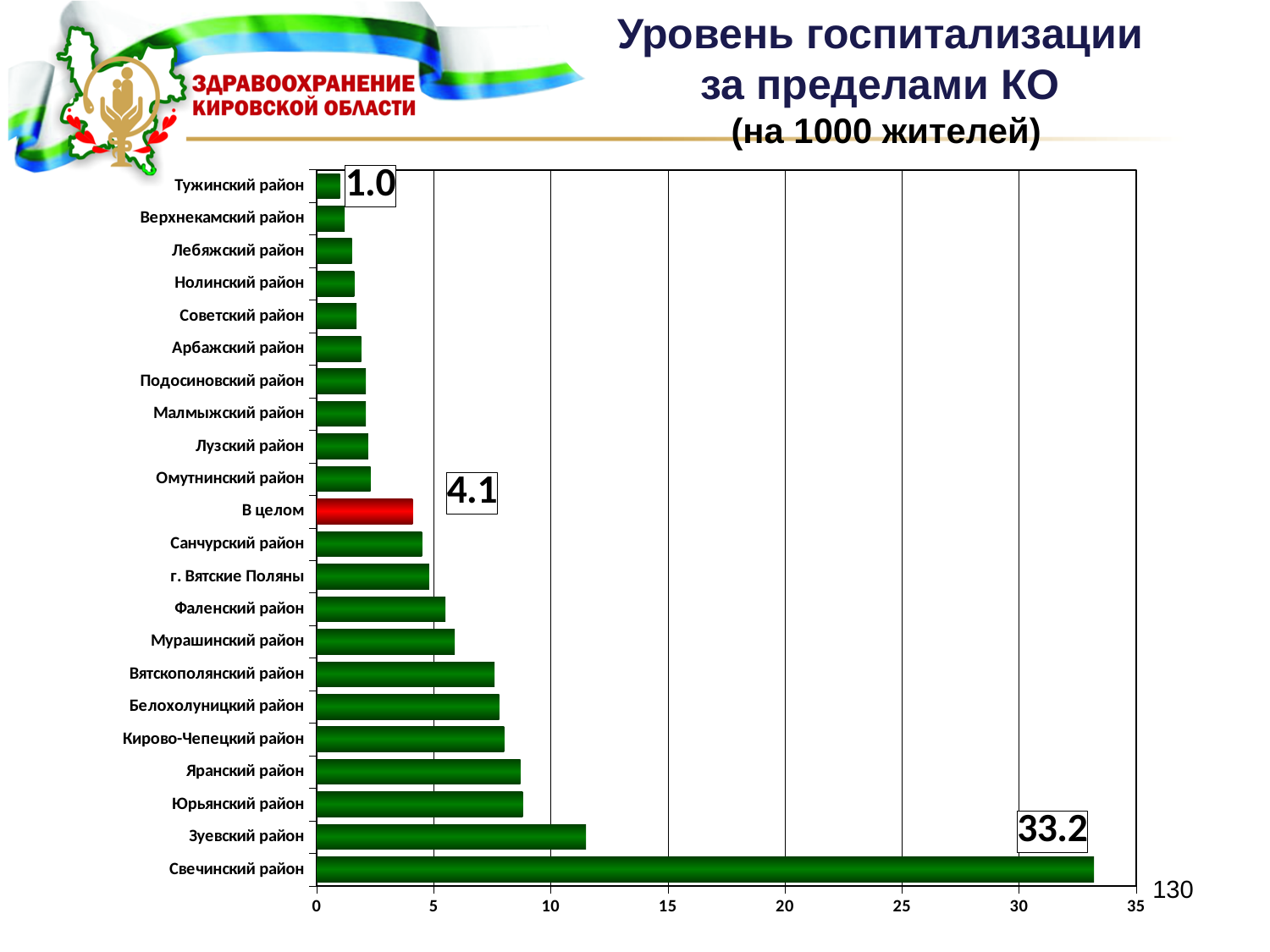
What is the difference between the values for Свечинский район and Тужинский район? 32.2 Is the value for Кирово-Чепецкий район greater or less than 10? less What is the value for В целом? 4.1 Is the value for Зуевский район greater or less than 10? greater Which category's bar is coloured red? В целом How many categories are shown on the chart? 22 What is the value for Свечинский район? 33.2 Which category has the highest value? Свечинский район Which is larger, the value for Зуевский район or the value for Юрьянский район? Зуевский район What kind of chart is shown on the slide? bar chart What is the value for Тужинский район? 1.0 What is the difference between the values for Свечинский район and В целом? 29.1